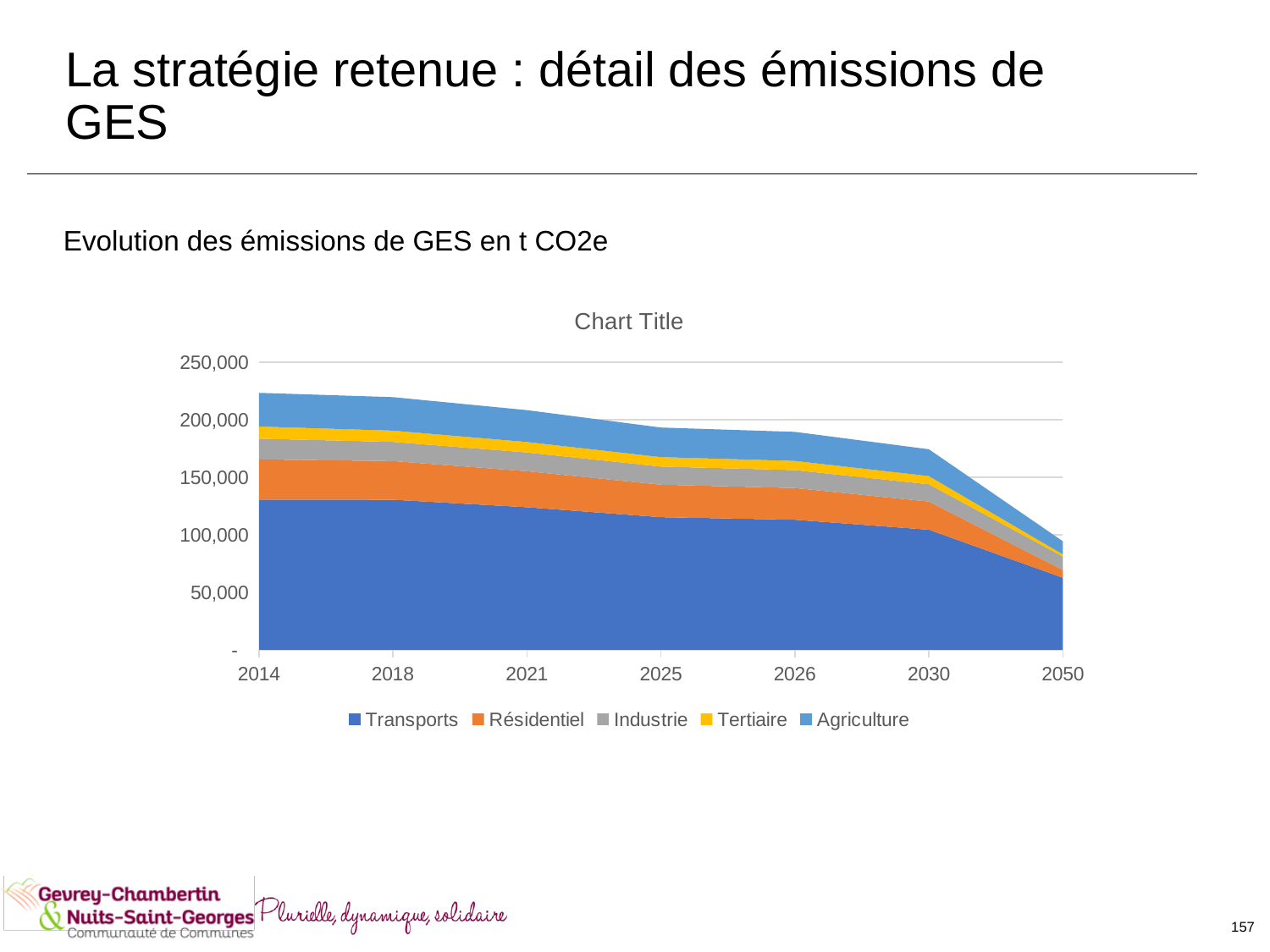
Which series occupies the largest band in the chart? Transports Is the Transports value for 2014 greater or less than 100,000? greater Is the total emissions value for 2050 greater or less than 100,000? less Is the total emissions value for 2014 greater or less than 200,000? greater What kind of chart is shown on the slide? area chart In which year is the total of all series highest? 2014 Which series is listed first in the legend? Transports Do total GES emissions rise or fall from 2014 to 2050? fall How many years are shown along the x axis? 7 How many series does the legend list? 5 In which year is the total of all series lowest? 2050